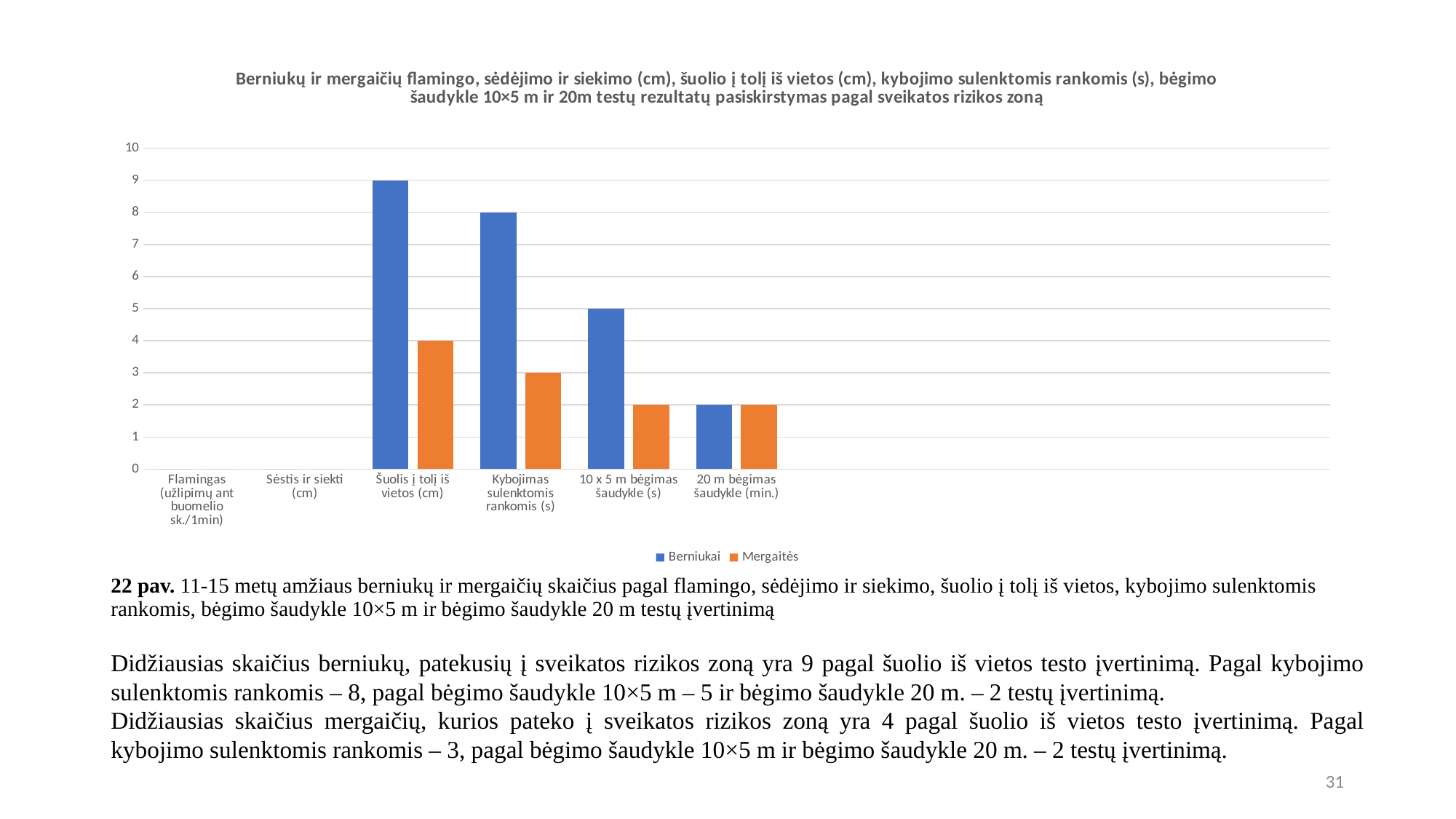
What kind of chart is shown on the slide? bar chart What is the value for Berniukai in the category Kybojimas sulenktomis rankomis (s)? 8 Which is larger in the category 10 x 5 m bėgimas šaudykle (s): the Berniukai value or the Mergaitės value? Berniukai Is the value for Berniukai in the category Šuolis į tolį iš vietos (cm) greater or less than 5? greater How many series does the legend list? 2 Which category has the highest value for Berniukai? Šuolis į tolį iš vietos (cm) What is the value for Mergaitės in the category 10 x 5 m bėgimas šaudykle (s)? 2 What is the value for Mergaitės in the category Šuolis į tolį iš vietos (cm)? 4 What is the difference between the Berniukai and Mergaitės values in the category Kybojimas sulenktomis rankomis (s)? 5 Which colour represents the Mergaitės series? orange How many categories are shown on the x axis? 6 What is the value for Berniukai in the category Šuolis į tolį iš vietos (cm)? 9